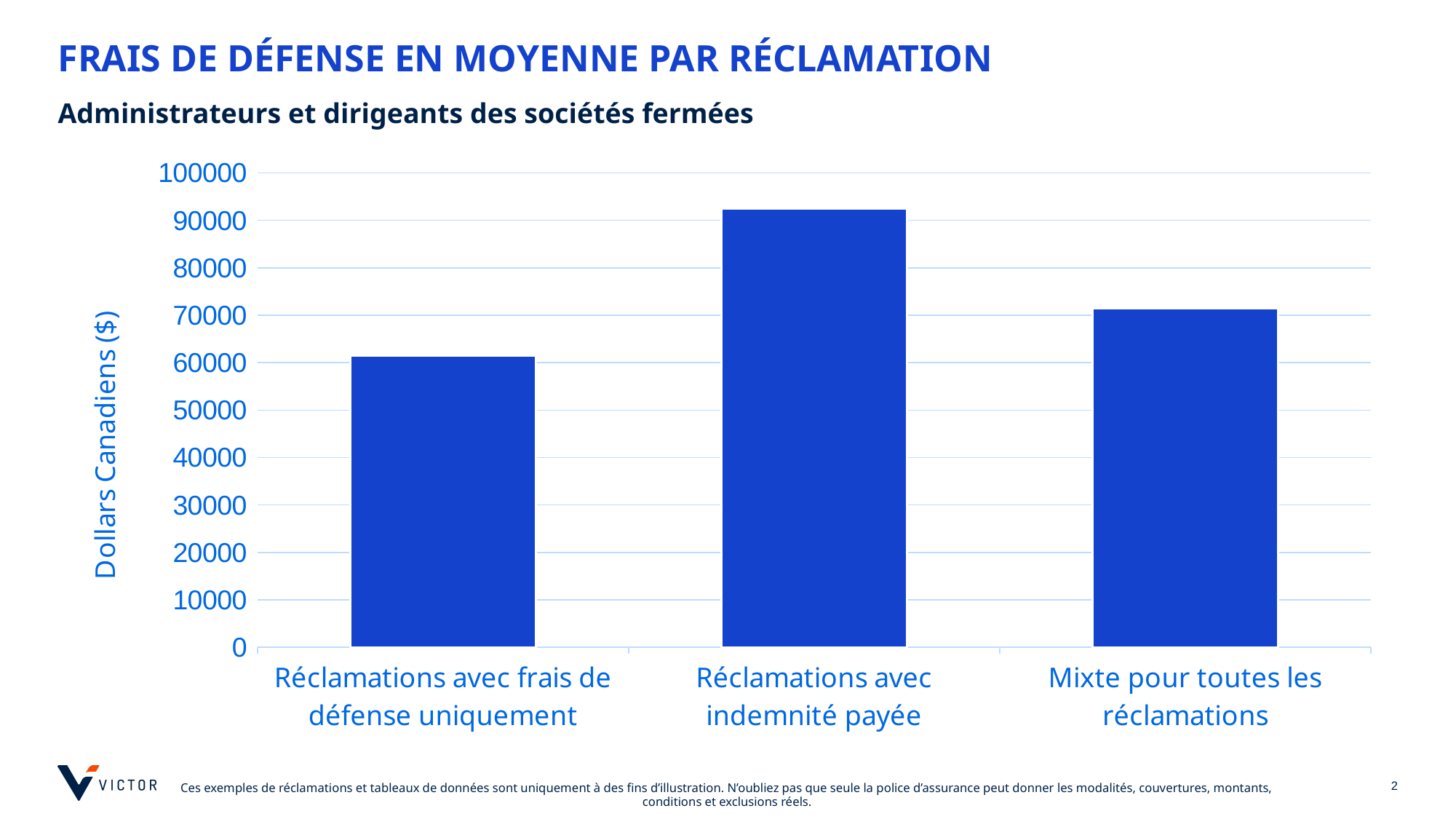
What is the title of the slide containing the chart? FRAIS DE DÉFENSE EN MOYENNE PAR RÉCLAMATION Is the value for 'Réclamations avec indemnité payée' greater or less than 90000? greater Which category has the highest average defence cost? Réclamations avec indemnité payée Is the value for 'Réclamations avec frais de défense uniquement' greater or less than 70000? less Is the value for 'Mixte pour toutes les réclamations' greater or less than 80000? less Which category has the lowest average defence cost? Réclamations avec frais de défense uniquement What is the label of the vertical axis? Dollars Canadiens ($) How many categories are plotted on the chart? 3 What kind of chart is shown on the slide? bar chart Which is larger: the value for 'Réclamations avec frais de défense uniquement' or the value for 'Mixte pour toutes les réclamations'? Mixte pour toutes les réclamations Which is larger: the value for 'Réclamations avec indemnité payée' or the value for 'Mixte pour toutes les réclamations'? Réclamations avec indemnité payée